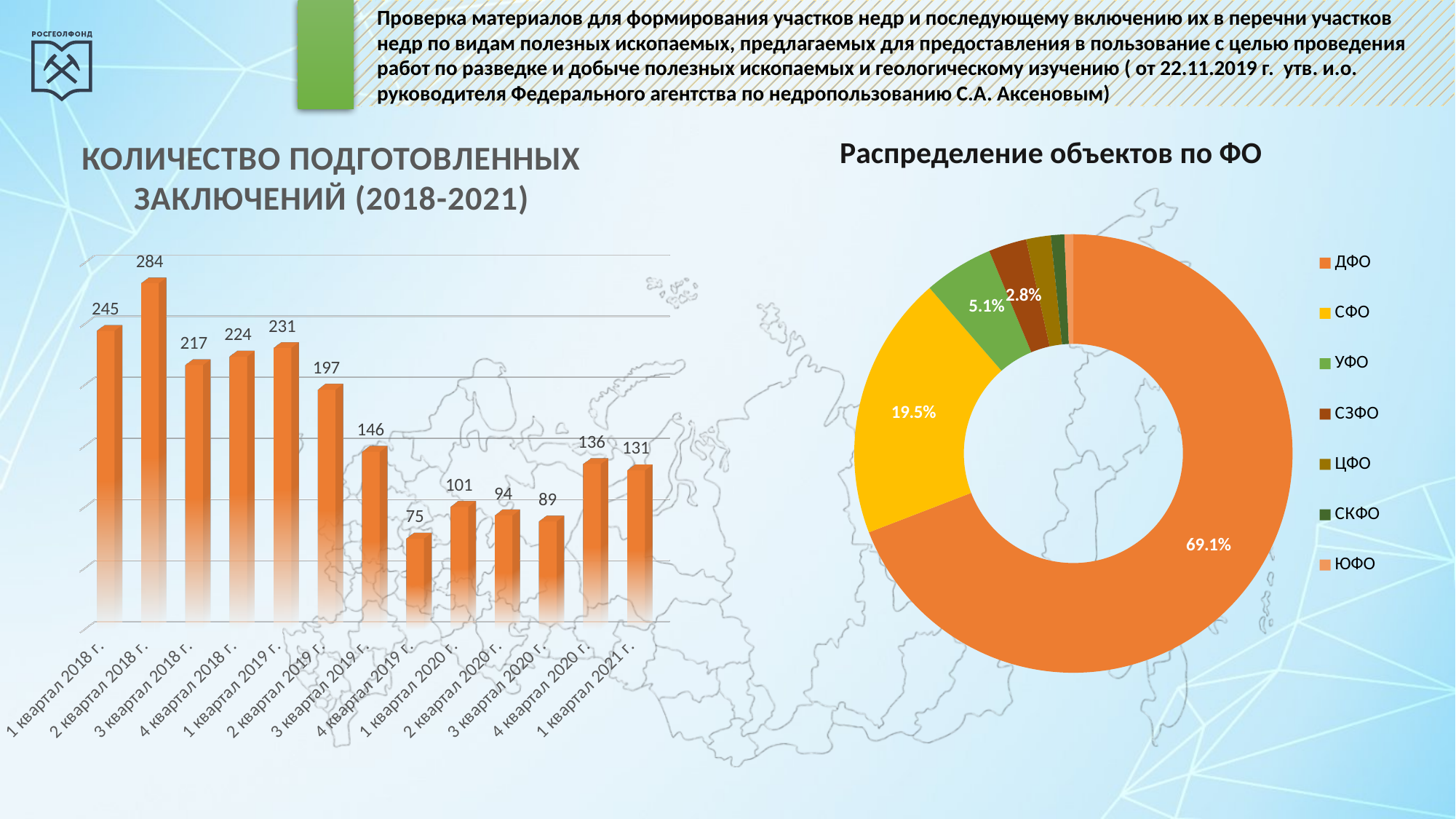
In the bar chart 'КОЛИЧЕСТВО ПОДГОТОВЛЕННЫХ ЗАКЛЮЧЕНИЙ (2018-2021)', what is the value for 1 квартал 2021 г.? 131 In the bar chart 'КОЛИЧЕСТВО ПОДГОТОВЛЕННЫХ ЗАКЛЮЧЕНИЙ (2018-2021)', what is the value for 4 квартал 2019 г.? 75 How many bars are in the bar chart 'КОЛИЧЕСТВО ПОДГОТОВЛЕННЫХ ЗАКЛЮЧЕНИЙ (2018-2021)'? 13 How many entries does the legend of the chart 'Распределение объектов по ФО' list? 7 In the bar chart 'КОЛИЧЕСТВО ПОДГОТОВЛЕННЫХ ЗАКЛЮЧЕНИЙ (2018-2021)', which quarter has the lowest value? 4 квартал 2019 г. In the bar chart 'КОЛИЧЕСТВО ПОДГОТОВЛЕННЫХ ЗАКЛЮЧЕНИЙ (2018-2021)', which quarter has the highest value? 2 квартал 2018 г. What kind of chart is 'КОЛИЧЕСТВО ПОДГОТОВЛЕННЫХ ЗАКЛЮЧЕНИЙ (2018-2021)'? Bar chart In the chart 'Распределение объектов по ФО', what share does СФО have? 19.5% In the bar chart 'КОЛИЧЕСТВО ПОДГОТОВЛЕННЫХ ЗАКЛЮЧЕНИЙ (2018-2021)', what is the value for 2 квартал 2018 г.? 284 In the bar chart 'КОЛИЧЕСТВО ПОДГОТОВЛЕННЫХ ЗАКЛЮЧЕНИЙ (2018-2021)', which is larger: the value for 4 квартал 2020 г. or 1 квартал 2021 г.? 4 квартал 2020 г. In the bar chart 'КОЛИЧЕСТВО ПОДГОТОВЛЕННЫХ ЗАКЛЮЧЕНИЙ (2018-2021)', what is the difference between the values for 1 квартал 2019 г. and 2 квартал 2019 г.? 34 In the chart 'Распределение объектов по ФО', what share does ДФО have? 69.1%